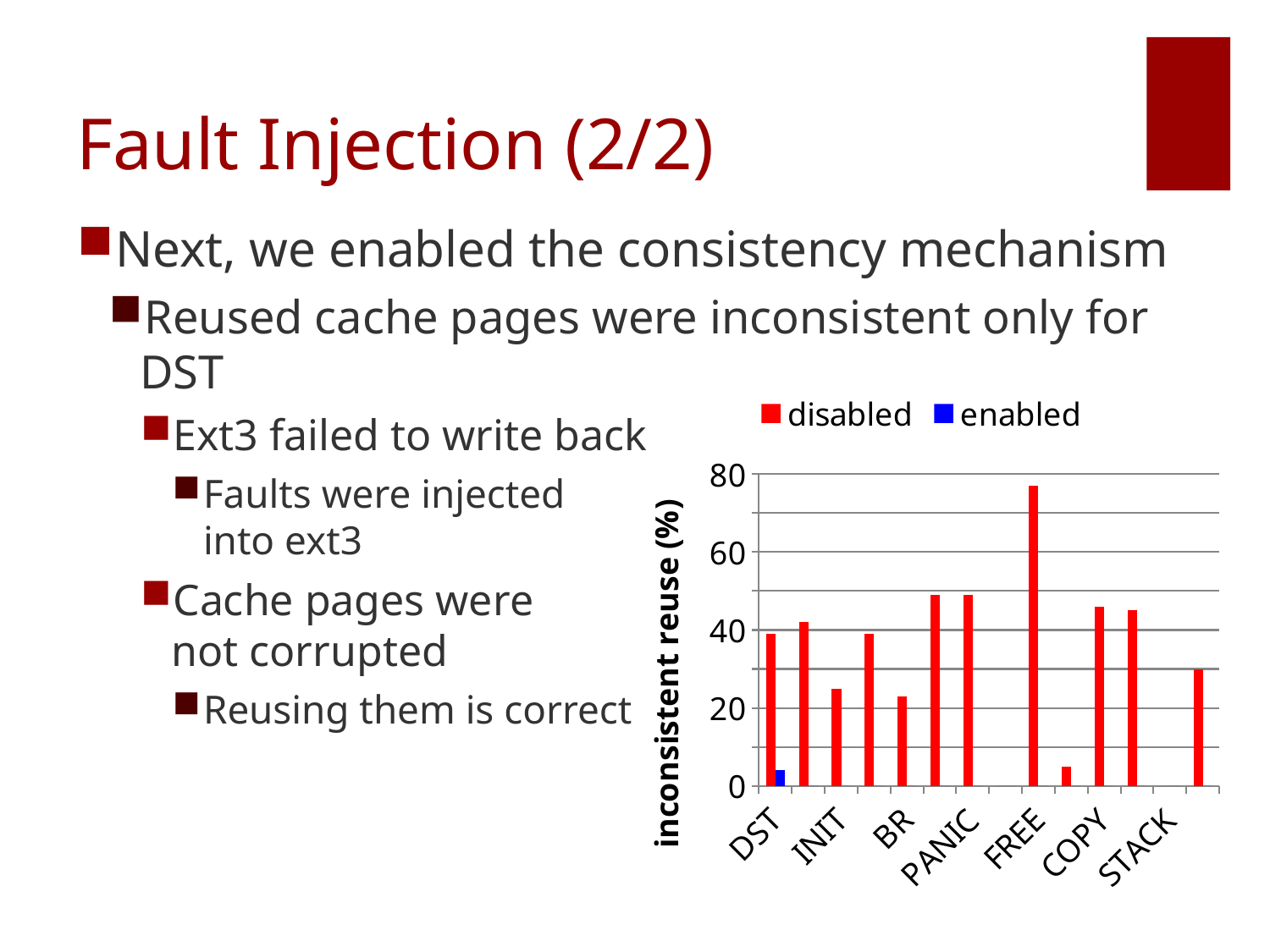
Which is larger for DST, the 'disabled' value or the 'enabled' value? disabled What is the label on the chart's vertical axis? inconsistent reuse (%) Which is larger, the 'disabled' value for FREE or the 'disabled' value for DST? FREE How many category labels are shown along the x axis of the chart? 7 Is the 'enabled' value for DST greater or less than 20? less Which category has the highest 'disabled' value in the chart? FREE Is the 'disabled' value for FREE greater or less than 60? greater What are the two series named in the chart legend? disabled and enabled Which category is the only one with a visible 'enabled' bar in the chart? DST What kind of chart is shown on the slide? bar chart How many series does the chart legend list? 2 Is the 'disabled' value for BR greater or less than 40? less